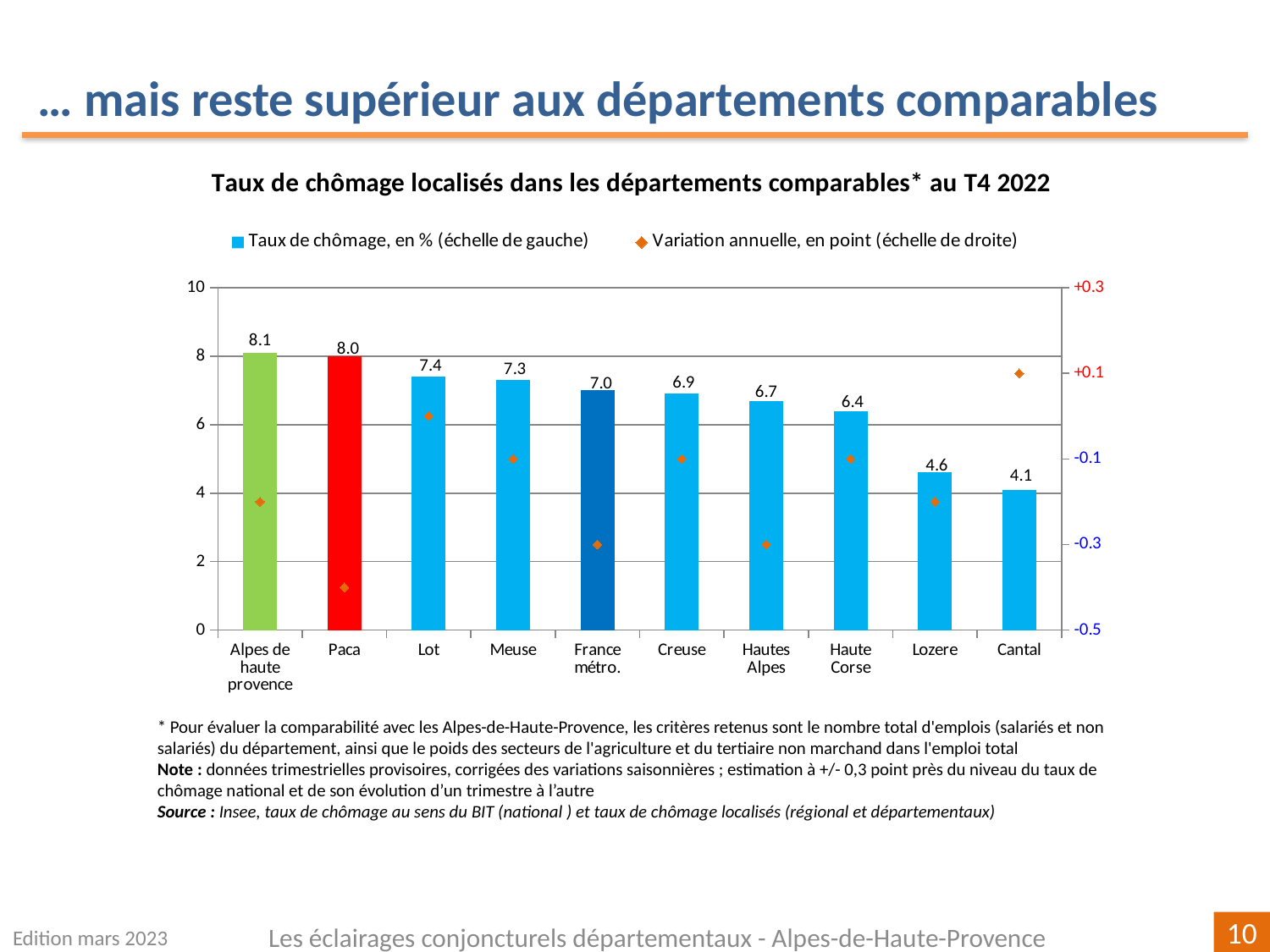
What is the difference between the unemployment rates of Alpes de haute provence and Cantal? 4.0 Is the annual variation (Variation annuelle) for Cantal greater or less than -0.1? greater Do the unemployment rate bars rise or fall from left to right along the x axis? fall What is the unemployment rate shown for Lozere? 4.6 Which department has the highest unemployment rate on the chart? Alpes de haute provence How many departments or categories are shown on the x axis? 10 What is the unemployment rate (Taux de chômage) for Alpes de haute provence? 8.1 What is the unemployment rate shown for France métro.? 7.0 Which has a higher unemployment rate, Creuse or Haute Corse? Creuse Is the annual variation (Variation annuelle) for Paca greater or less than -0.3? less Which category has the lowest unemployment rate on the chart? Cantal How many series does the legend list? 2